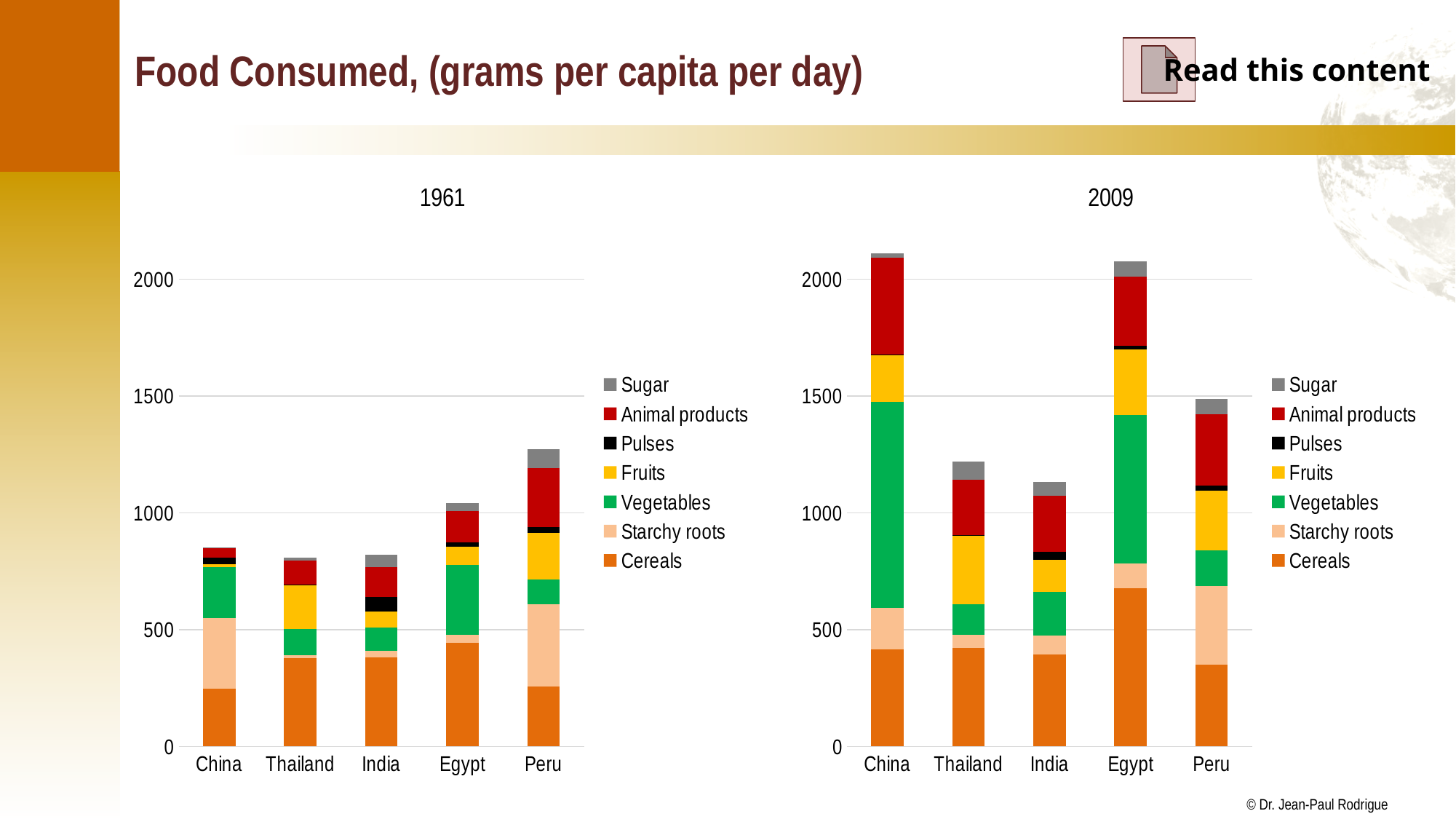
In the 2009 chart, which is larger, the total for Peru or the total for India? Peru How many countries are shown on the x axis of the 2009 chart? 5 In the 1961 chart, which country has the highest total food consumed? Peru In the 1961 chart, which is larger, the total for Egypt or the total for Thailand? Egypt In the 2009 chart, which series is listed first in the legend? Sugar In the 2009 chart, is the total for China greater or less than 2000? greater In the 2009 chart, is the total for India greater or less than 1000? greater In the 1961 chart, is the total for China greater or less than 1000? less How many series does the legend of the 1961 chart list? 7 In the 2009 chart, which is larger, the total for Egypt or the total for Thailand? Egypt What kind of chart is the 1961 chart? stacked bar chart